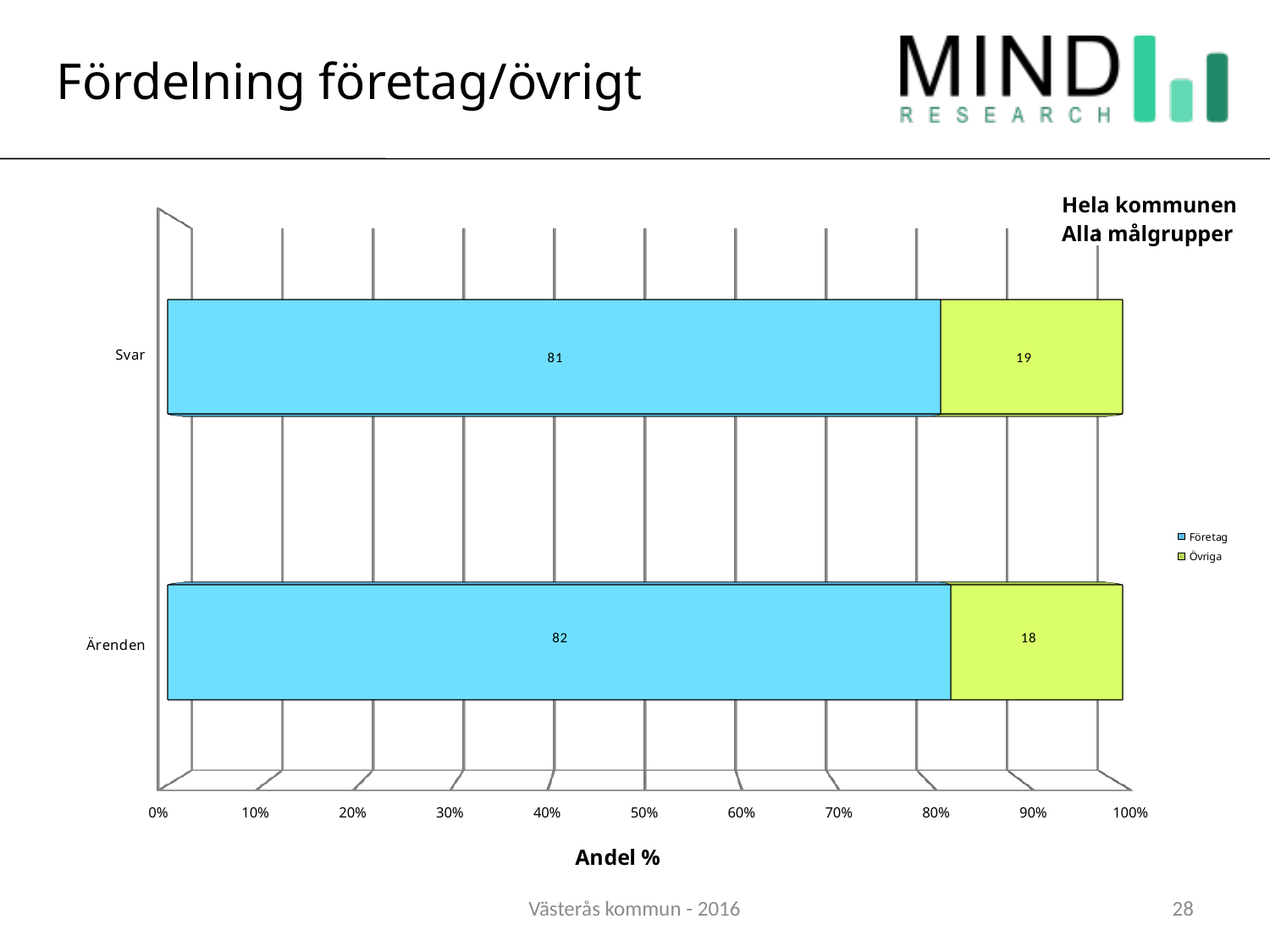
How many series does the legend list? 2 What is the value for Övriga in the Ärenden bar? 18 Which series is shown in blue? Företag How many categories are shown on the y axis? 2 Which category has the higher Företag value, Svar or Ärenden? Ärenden What kind of chart is shown on the slide? Stacked bar chart What is the value for Företag in the Svar bar? 81 What is the difference between the Företag values for Ärenden and Svar? 1 What is the label of the x axis? Andel % What is the value for Övriga in the Svar bar? 19 What is the value for Företag in the Ärenden bar? 82 What is the total of the Svar stacked bar? 100